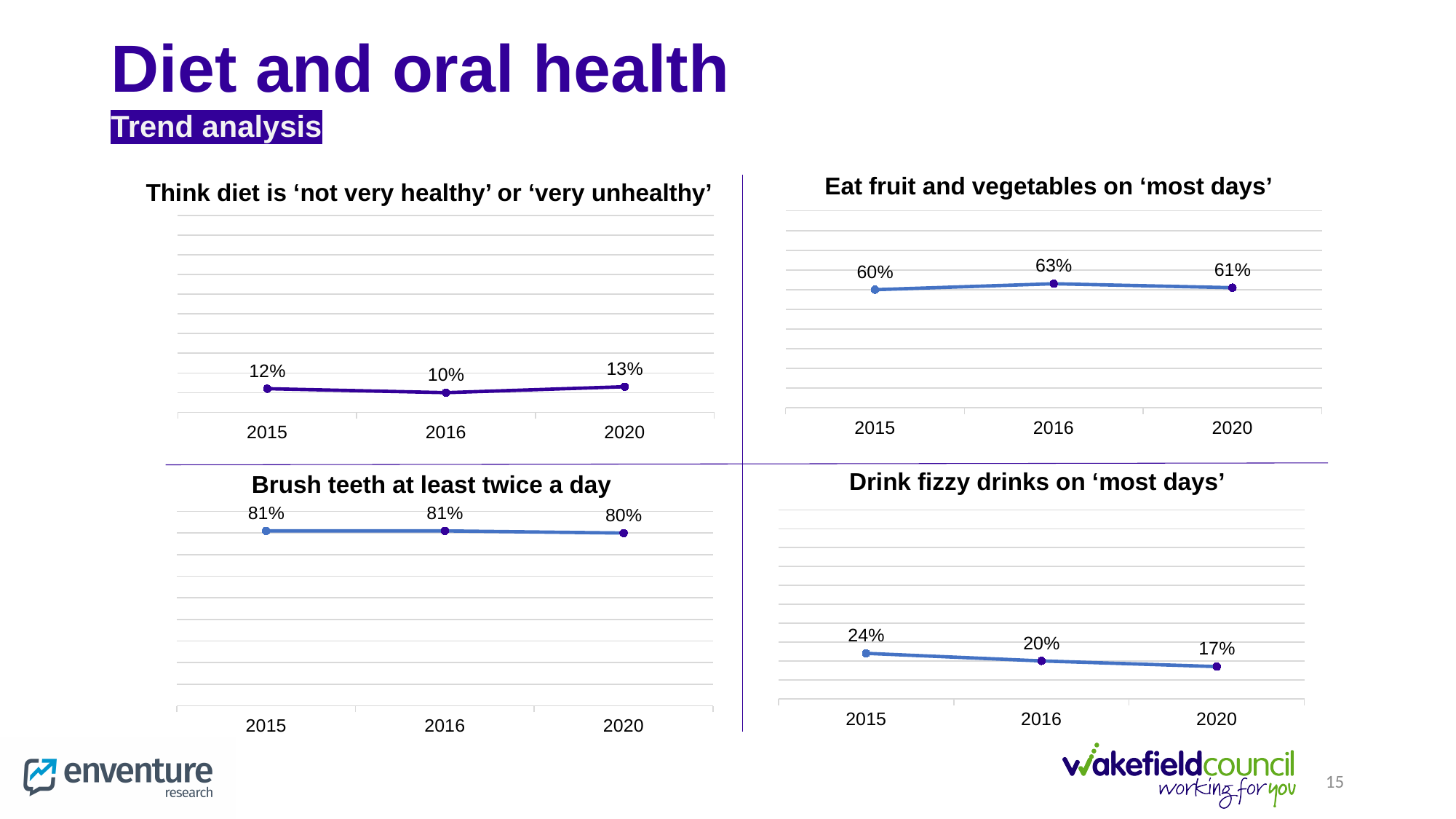
In the 'Eat fruit and vegetables on 'most days'' chart, is the value for 2015 or 2020 larger? 2020 In the 'Think diet is 'not very healthy' or 'very unhealthy'' chart, what is the value for 2016? 10% In the 'Drink fizzy drinks on 'most days'' chart, do the values rise or fall from 2015 to 2020? fall In the 'Eat fruit and vegetables on 'most days'' chart, what is the value for 2016? 63% In the 'Drink fizzy drinks on 'most days'' chart, what is the difference between the 2015 and 2020 values? 7% In the 'Drink fizzy drinks on 'most days'' chart, which year has the lowest value? 2020 In the 'Brush teeth at least twice a day' chart, what is the value for 2020? 80% In the 'Drink fizzy drinks on 'most days'' chart, what is the value for 2015? 24% In the 'Eat fruit and vegetables on 'most days'' chart, which year has the highest value? 2016 What kind of chart is the 'Drink fizzy drinks on 'most days'' chart? line chart How many data points are plotted in the 'Brush teeth at least twice a day' chart? 3 In the 'Think diet is 'not very healthy' or 'very unhealthy'' chart, what is the difference between the 2020 and 2016 values? 3%